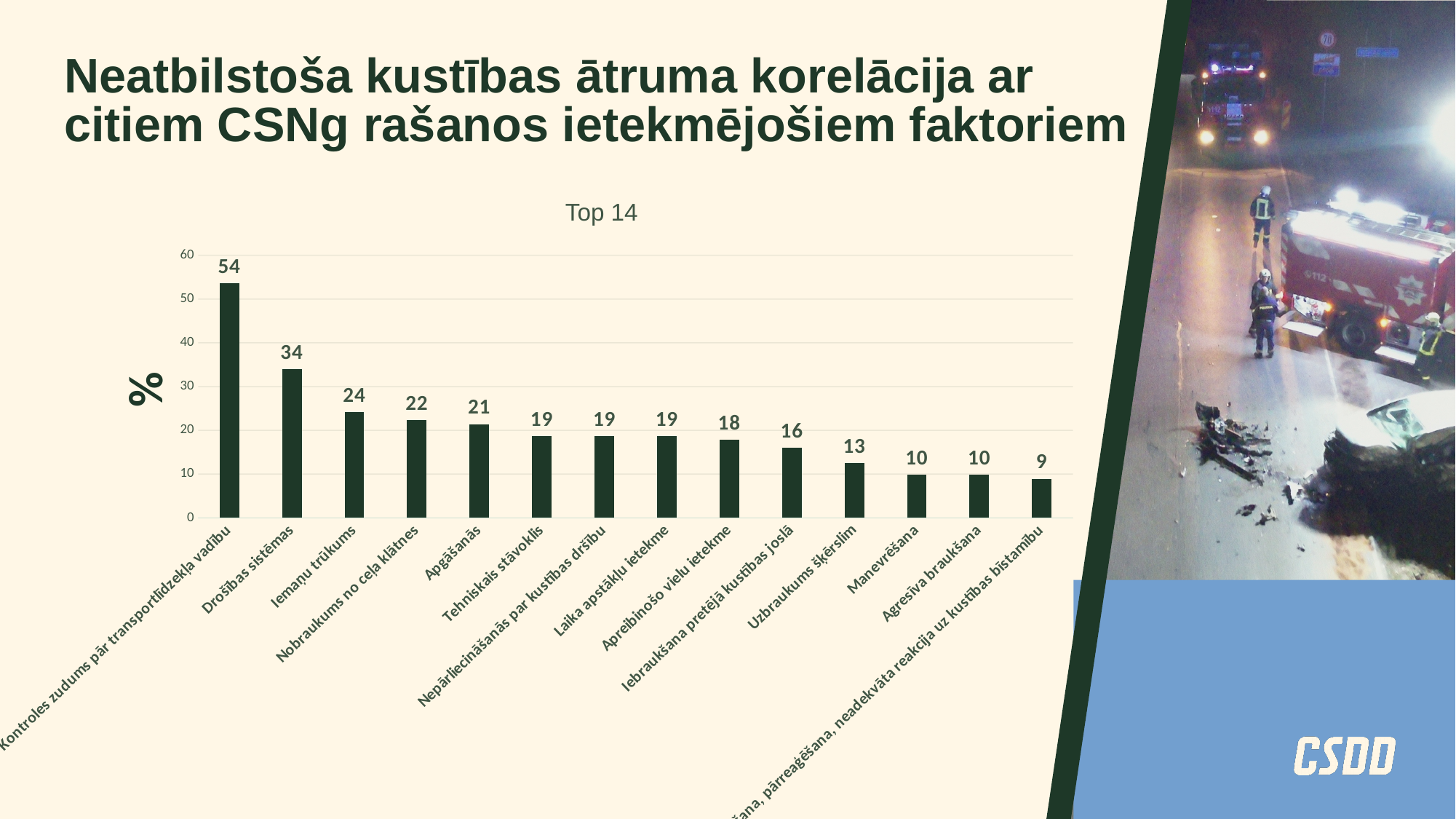
Is the value for Iebraukšana pretējā kustības joslā greater or less than 20? less What is the difference between the values for Iemaņu trūkums and Manevrēšana? 14 What is the difference between the values for Kontroles zudums pār transportlīdzekļa vadību and Drošības sistēmas? 20 What is the value for Apgāšanās? 21 What is the value for Uzbraukums šķērslim? 13 Which is larger, the value for Nobraukums no ceļa klātnes or the value for Apreibinošo vielu ietekme? Nobraukums no ceļa klātnes Which category has the highest value? Kontroles zudums pār transportlīdzekļa vadību What is the value for Kontroles zudums pār transportlīdzekļa vadību? 54 What kind of chart is shown on the slide? bar chart What is the value for Drošības sistēmas? 34 What is the title of the chart? Top 14 How many categories are shown in the chart? 14